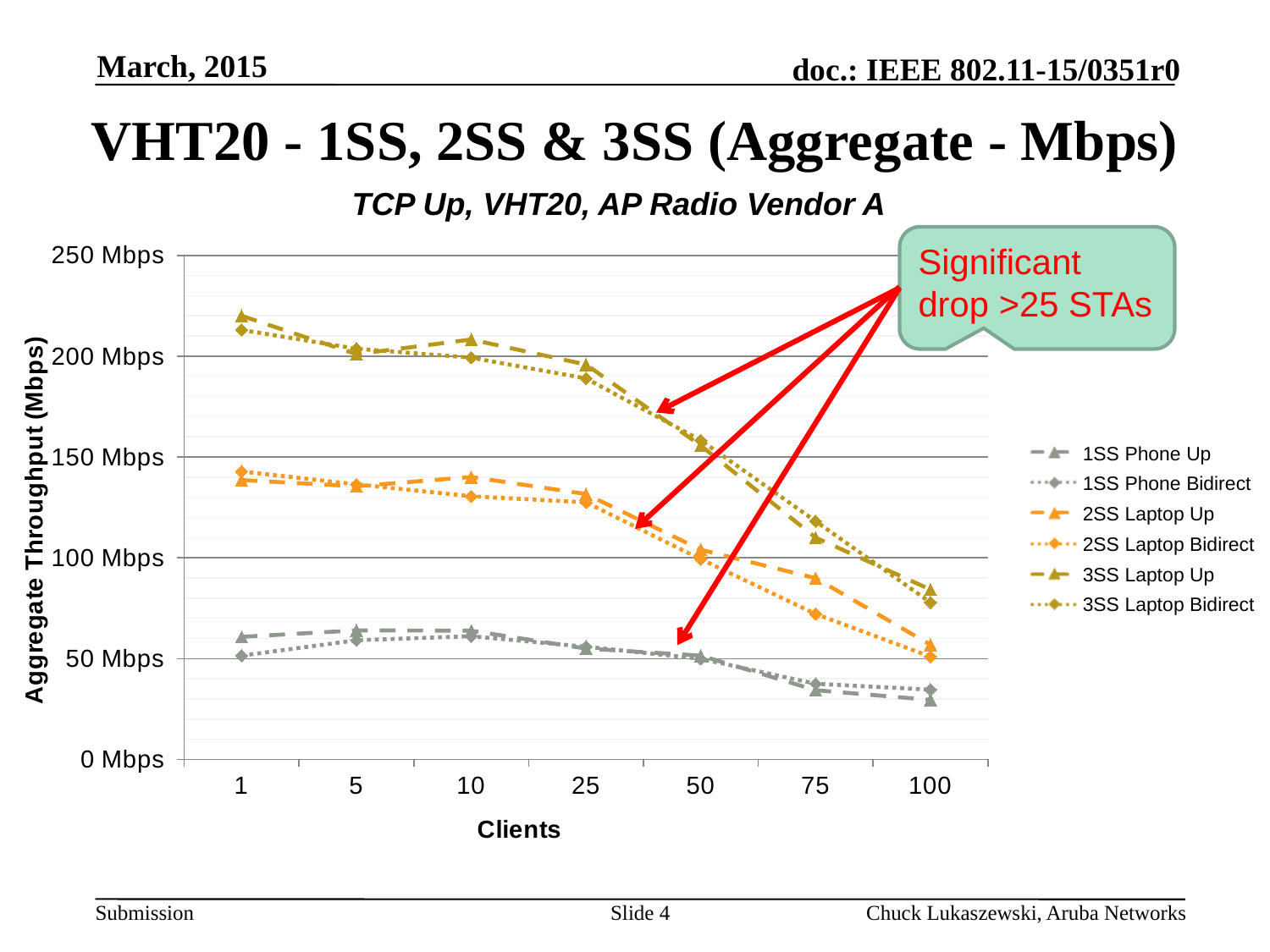
Do the values for 3SS Laptop Up rise or fall from 25 clients to 100 clients? fall What is the title of the chart? TCP Up, VHT20, AP Radio Vendor A Is the value for 2SS Laptop Up at 75 clients greater or less than 100 Mbps? less What kind of chart is shown on the slide? line chart How many series does the legend list? 6 Is the value for 3SS Laptop Up at 1 client greater or less than 200 Mbps? greater Which series has the highest value at 1 client? 3SS Laptop Up How many client counts are plotted along the x axis? 7 Is the value for 1SS Phone Up at 100 clients greater or less than 50 Mbps? less What is the label of the y axis? Aggregate Throughput (Mbps) At 25 clients, which is larger: 3SS Laptop Up or 1SS Phone Up? 3SS Laptop Up